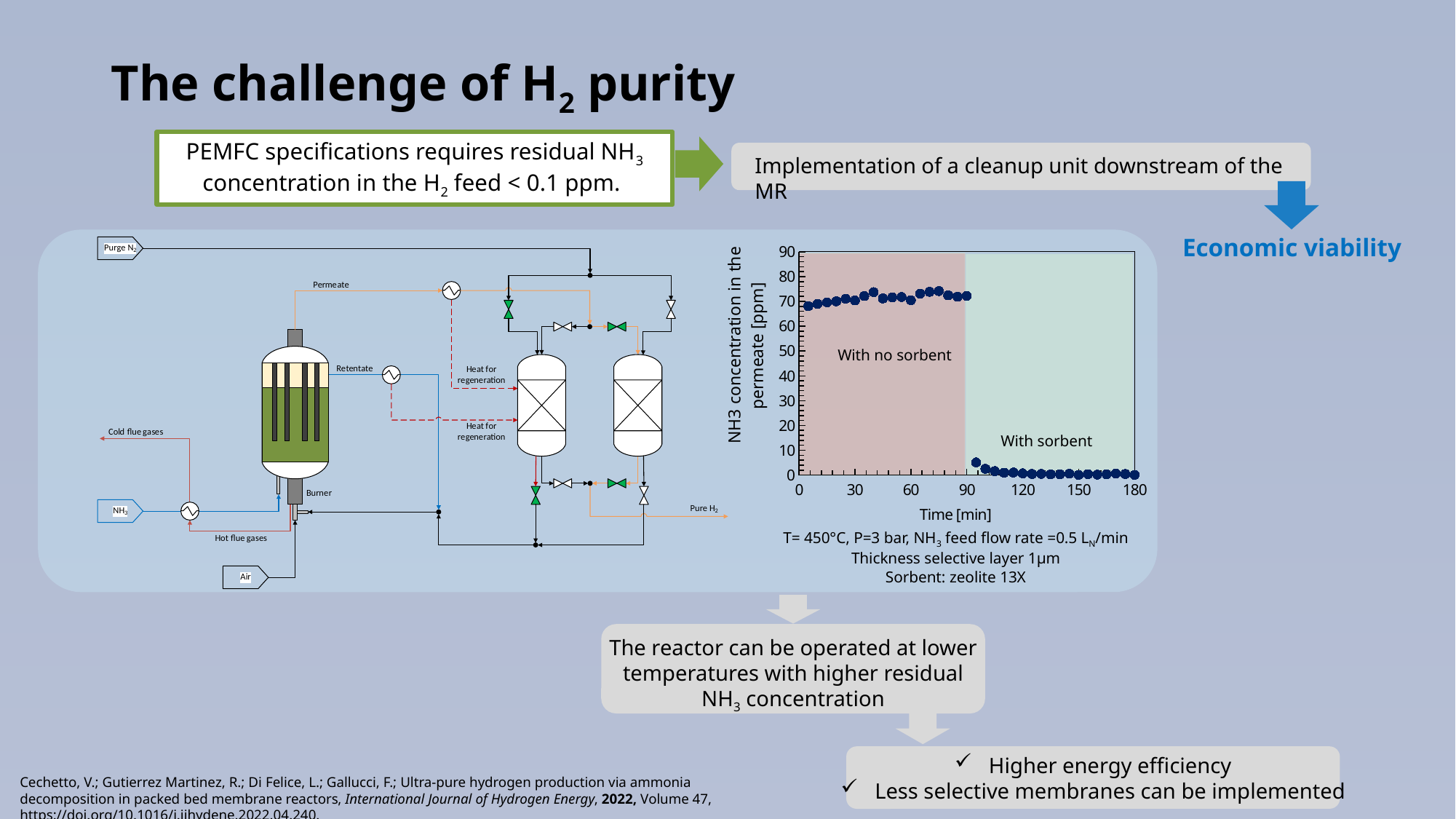
Does the NH3 concentration in the permeate rise or fall after 90 min on the chart? fall What is the label of the y axis of the chart? NH3 concentration in the permeate [ppm] Is the NH3 concentration in the permeate at 30 min greater or less than 60 ppm? greater What is the label of the x axis of the chart? Time [min] Is the NH3 concentration in the permeate at 120 min greater or less than 20 ppm? less What is the maximum value shown on the y axis of the chart? 90 What is the maximum value shown on the x axis of the chart? 180 What kind of chart is shown on the slide? scatter plot At what time on the x axis does the chart switch from the 'With no sorbent' region to the 'With sorbent' region? 90 min Is the NH3 concentration in the permeate at 60 min greater or less than 80 ppm? less Which region shows the higher NH3 concentration in the permeate, 'With no sorbent' or 'With sorbent'? With no sorbent